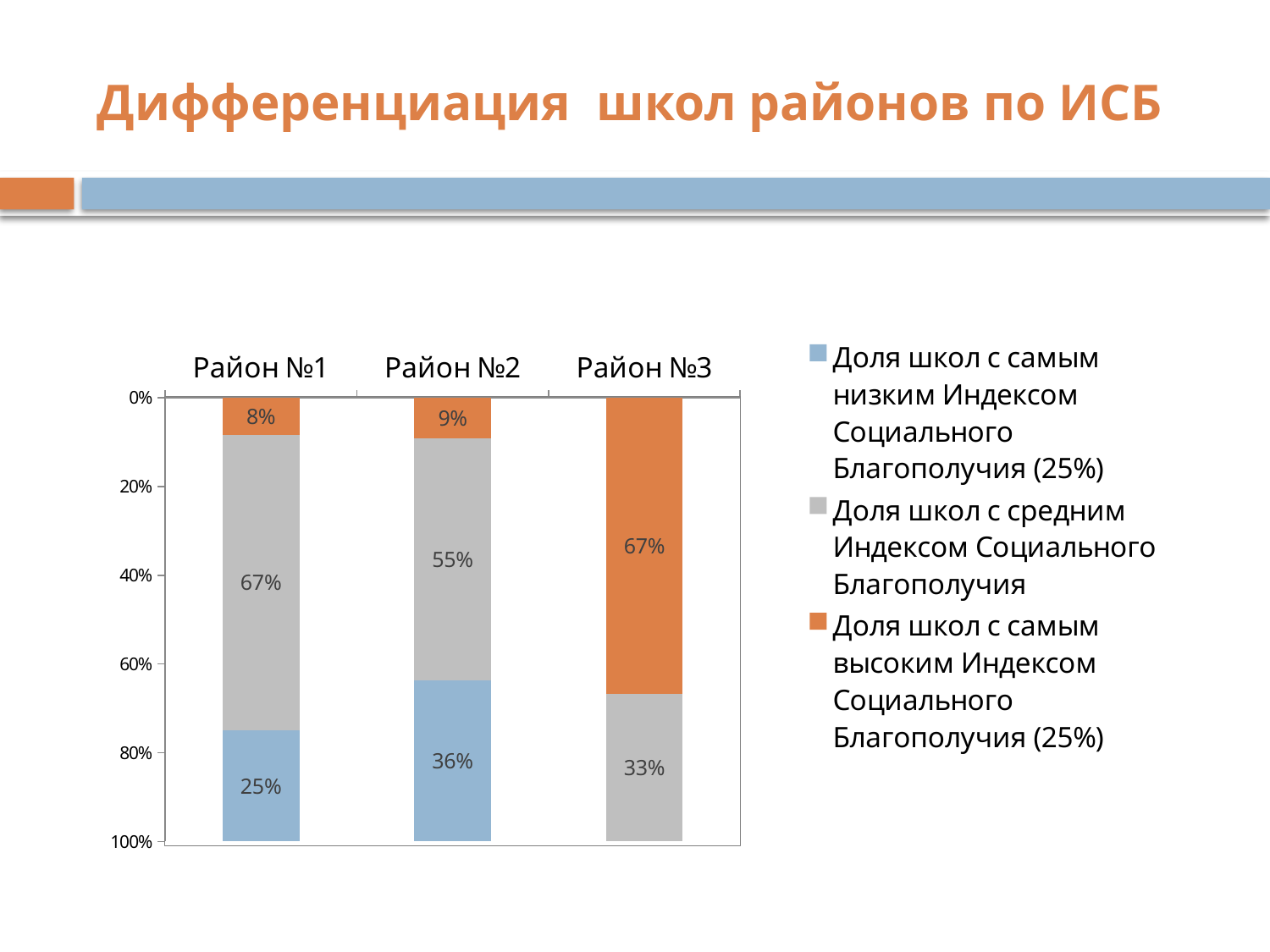
What share of schools in Район №3 has the highest Social Well-being Index (orange segment)? 67% What colour represents the share of schools with the medium Social Well-being Index? Gray What is the difference between the share of schools with the lowest index in Район №2 and in Район №1 (blue segments)? 11% Which is larger: the medium-index share (gray) in Район №1 or in Район №2? Район №1 What kind of chart is shown on the slide? Stacked bar chart How many districts are shown on the chart? 3 What share of schools in Район №1 has the lowest Social Well-being Index (blue segment)? 25% What share of schools in Район №2 has the medium Social Well-being Index (gray segment)? 55% How many series does the legend list? 3 Which district has the largest share of schools with the highest Social Well-being Index (orange segment)? Район №3 What share of schools in Район №2 has the highest Social Well-being Index (orange segment)? 9% Which district has the smallest share of schools with the highest Social Well-being Index (orange segment)? Район №1